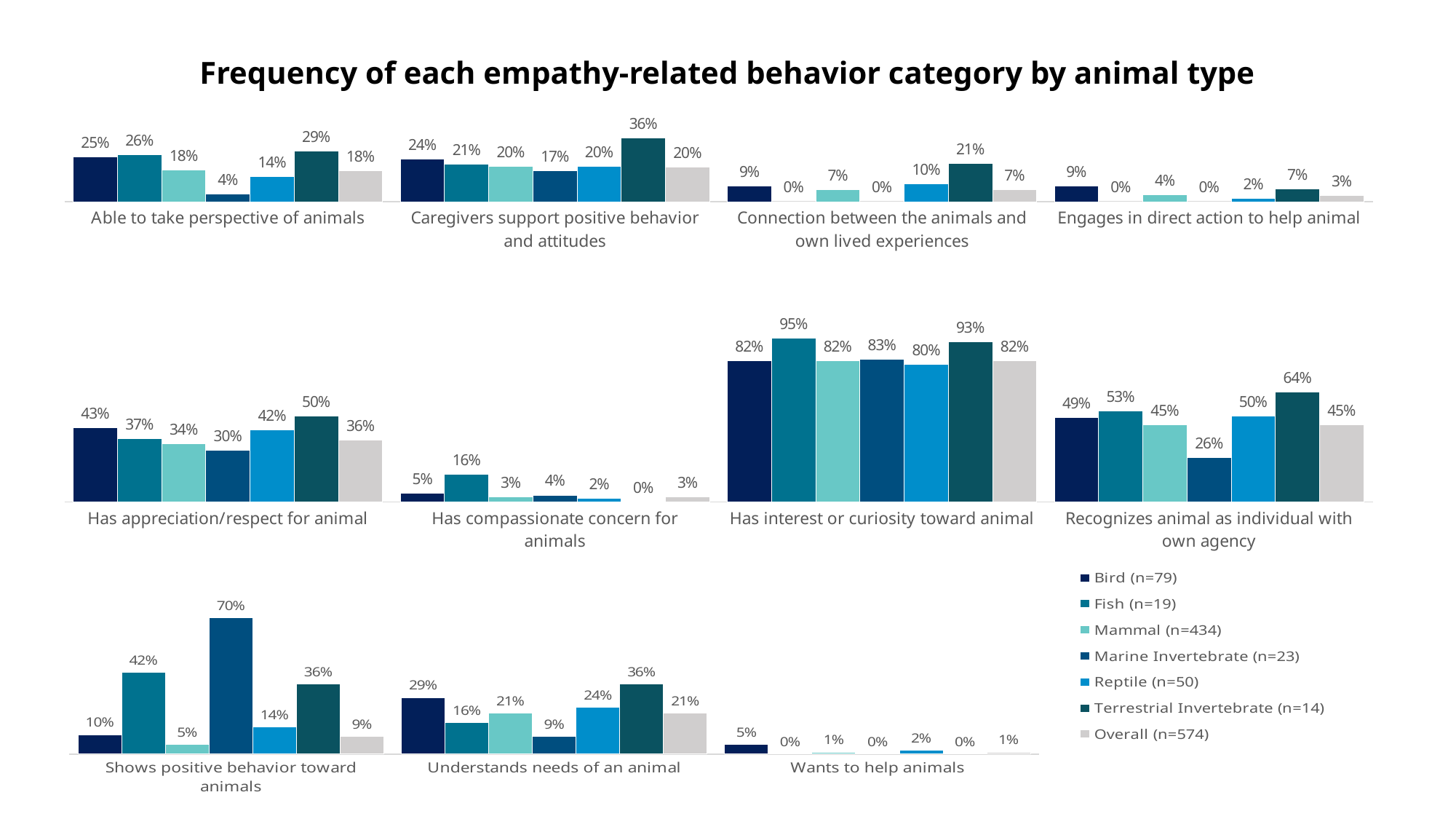
In the 'Caregivers support positive behavior and attitudes' chart, what is the Overall value? 20% In the 'Has appreciation/respect for animal' chart, which animal type has the lowest value? Marine Invertebrate In the 'Wants to help animals' chart, what is the value for Bird? 5% What kind of chart is used in each panel of the slide? Bar chart In the 'Understands needs of an animal' chart, what is the difference between the Terrestrial Invertebrate value and the Marine Invertebrate value? 27% In the 'Has compassionate concern for animals' chart, which is larger: the value for Fish or the value for Bird? Fish In the 'Connection between the animals and own lived experiences' chart, what is the difference between the Terrestrial Invertebrate value and the Reptile value? 11% According to the legend, what is the sample size for Mammal? n=434 In the 'Shows positive behavior toward animals' chart, what is the value for Marine Invertebrate? 70% In the 'Has interest or curiosity toward animal' chart, what is the value for Fish? 95% How many series does the legend list? 7 In the 'Recognizes animal as individual with own agency' chart, which animal type has the highest value? Terrestrial Invertebrate